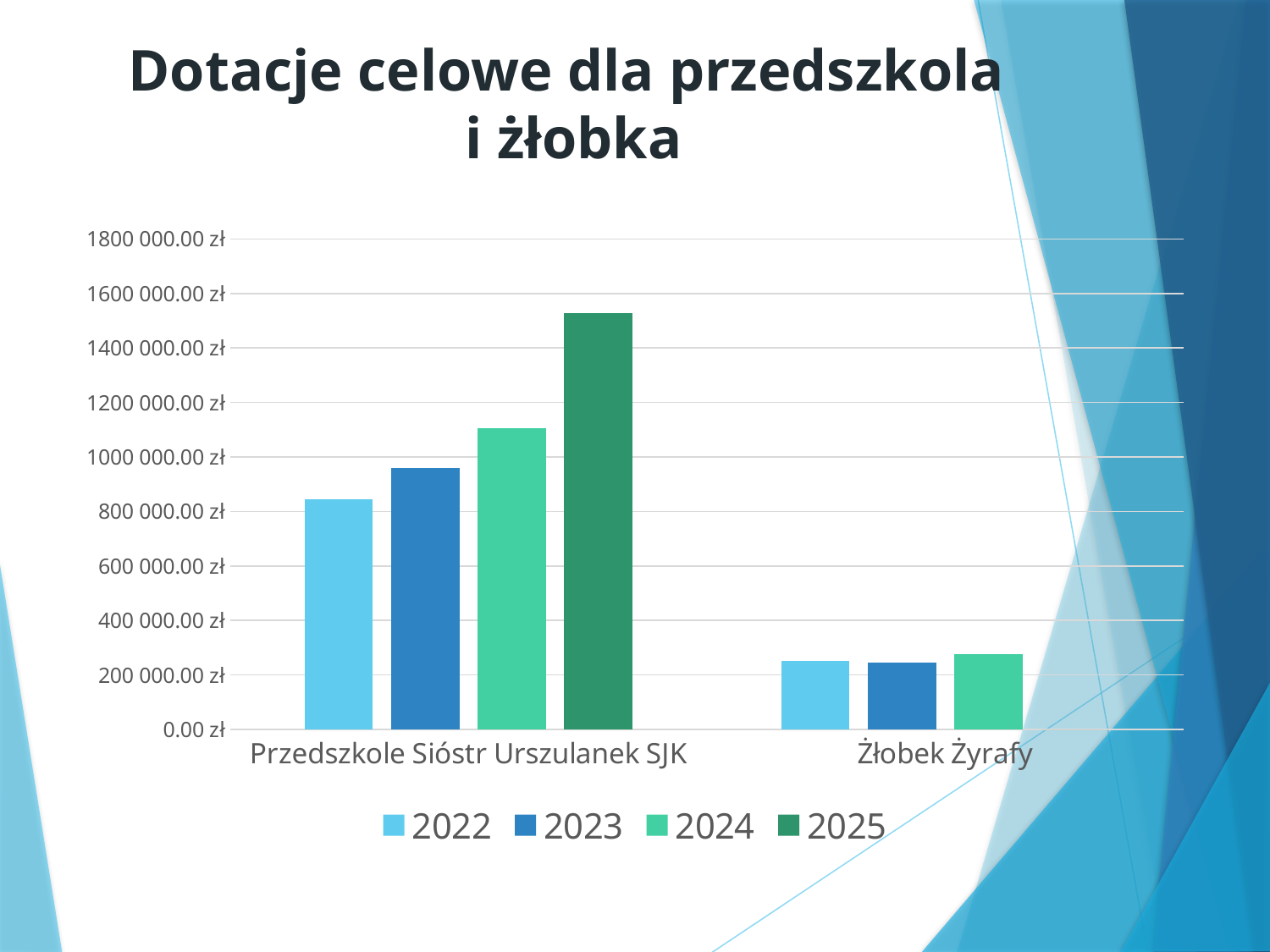
What kind of chart is shown on the slide? bar chart Is the 2022 value for Przedszkole Sióstr Urszulanek SJK greater or less than 1000 000.00 zł? less Which is larger, the 2024 value for Przedszkole Sióstr Urszulanek SJK or the 2024 value for Żłobek Żyrafy? Przedszkole Sióstr Urszulanek SJK What is the title of the chart? Dotacje celowe dla przedszkola i żłobka Is the 2024 value for Żłobek Żyrafy greater or less than 400 000.00 zł? less Do the values for Przedszkole Sióstr Urszulanek SJK rise or fall from 2022 to 2025? rise Which year has the highest value for Przedszkole Sióstr Urszulanek SJK? 2025 Is the 2025 value for Przedszkole Sióstr Urszulanek SJK greater or less than 1400 000.00 zł? greater How many series does the legend list? 4 How many categories are shown on the x axis? 2 Which year has the lowest value for Przedszkole Sióstr Urszulanek SJK? 2022 Which year has the highest value for Żłobek Żyrafy? 2024